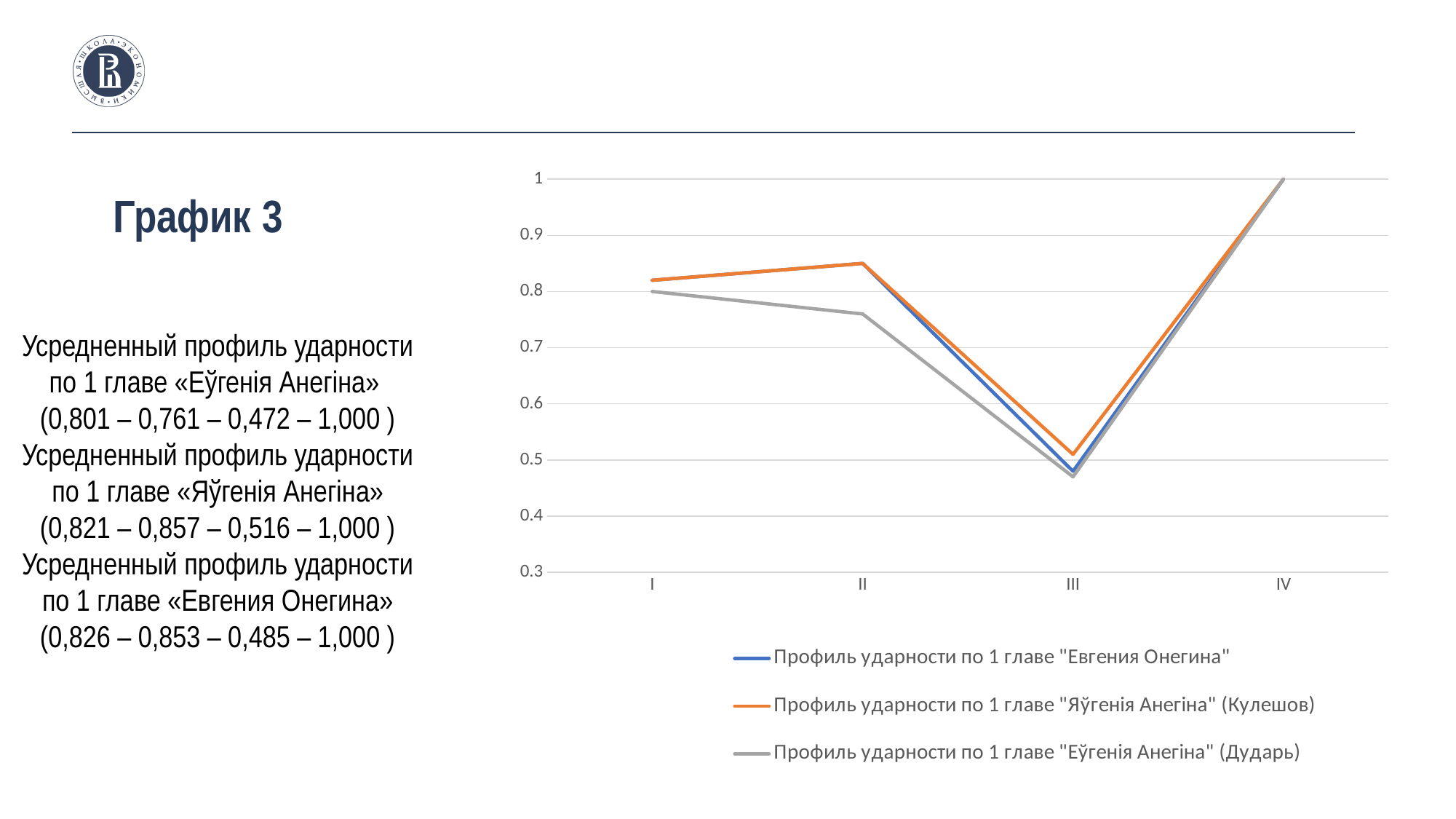
How many series does the chart legend list? 3 Is the value for "Еўгенія Анегіна" (Дударь) at III greater or less than 0.5? less At which x-axis category does the series "Яўгенія Анегіна" (Кулешов) reach its highest value? IV Is the value for "Еўгенія Анегіна" (Дударь) at II greater or less than 0.8? less Do the values of all three series rise or fall from II to III? fall Is the value for "Яўгенія Анегіна" (Кулешов) at II greater or less than 0.8? greater How many points are plotted along the x axis for each series? 4 At which x-axis category does the series "Еўгенія Анегіна" (Дударь) reach its lowest value? III What is the title shown on the slide for this chart? График 3 At category I, which series has the higher value: "Яўгенія Анегіна" (Кулешов) or "Еўгенія Анегіна" (Дударь)? Яўгенія Анегіна (Кулешов) What kind of chart is shown on the slide? line chart What value do all three series reach at category IV? 1